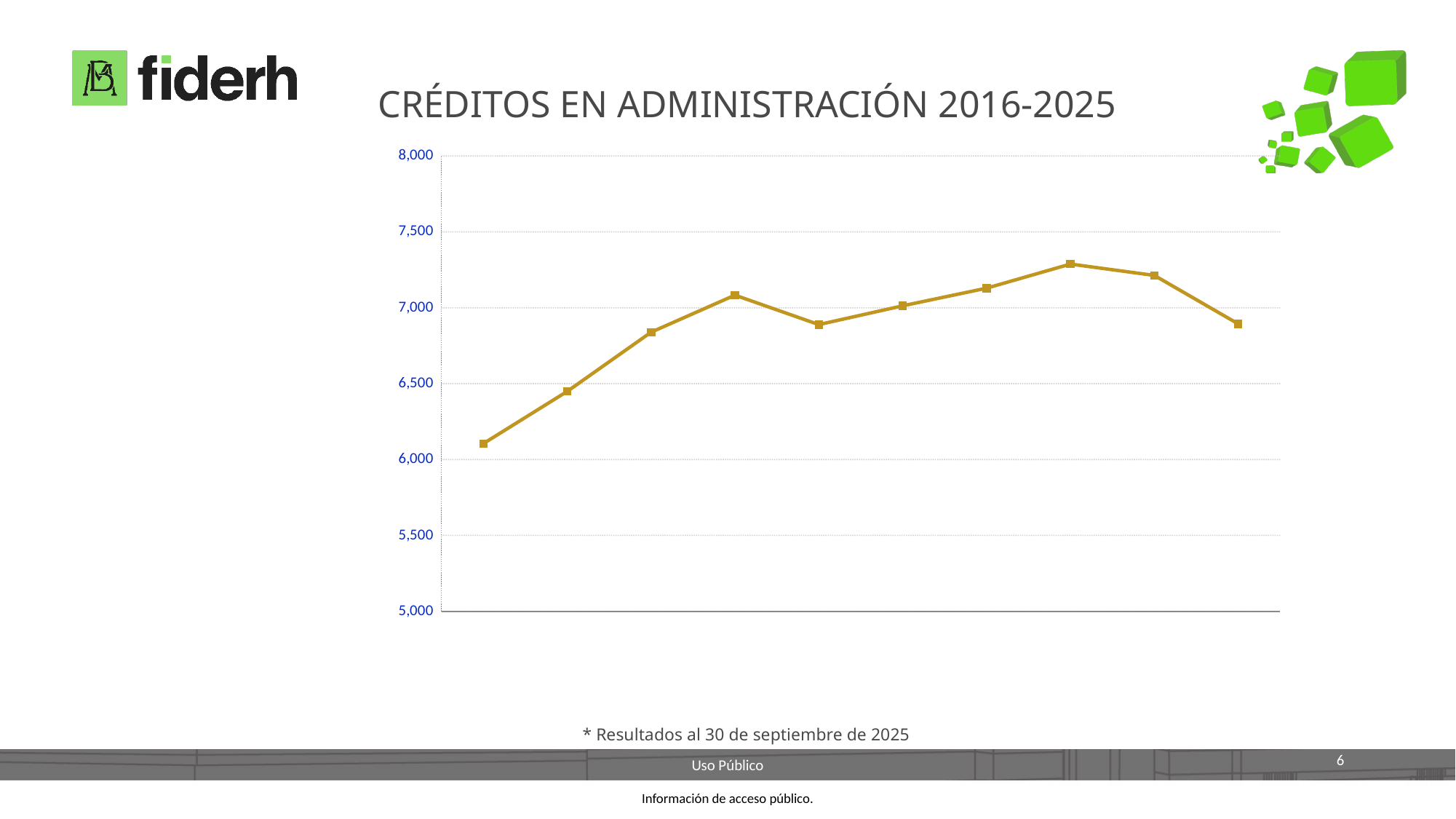
Which is larger, the value of the first point or the value of the last point on the line? the last point Is the value of the first point on the line greater or less than 6,500? less How many lines (series) are plotted on the chart? 1 What kind of chart is shown on the slide? line chart Does the line end higher or lower than where it starts? higher What are the minimum and maximum values shown on the vertical axis? 5,000 and 8,000 Is the value of the first point on the line greater or less than 6,000? greater What is the title of the chart? CRÉDITOS EN ADMINISTRACIÓN 2016-2025 How many data points are plotted on the line? 10 Is the highest point on the line greater or less than 7,500? less